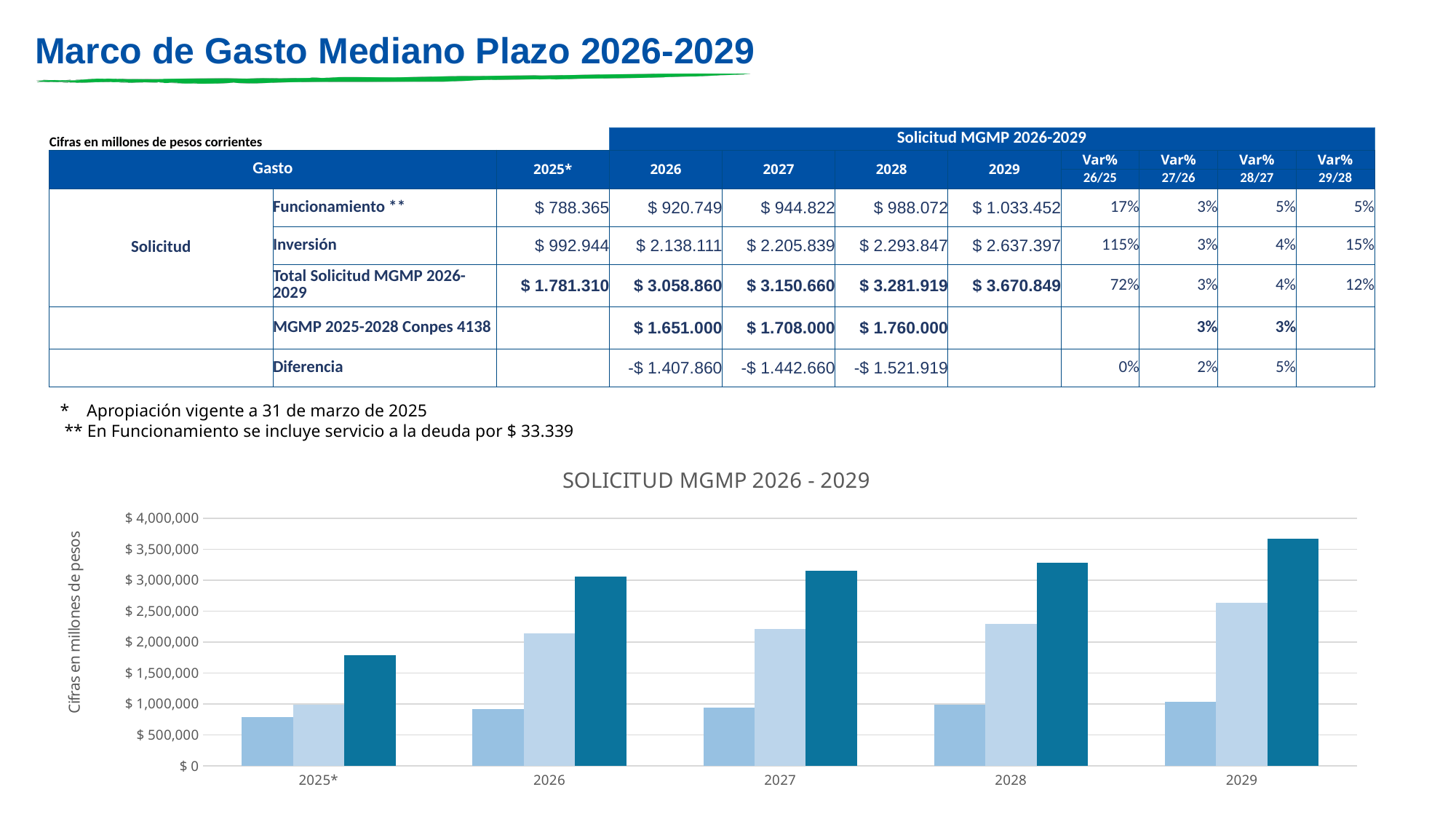
Is the lightest blue bar for 2025* greater or less than $ 1,000,000? less In which year is the tallest dark teal bar on the chart? 2029 Is the dark teal bar for 2029 greater or less than $ 3,500,000? greater What kind of chart is shown at the bottom of the slide? bar chart How many bars are plotted for each year on the chart? 3 How many year categories are shown on the x axis of the chart? 5 What is the title of the chart? SOLICITUD MGMP 2026 - 2029 What is the label on the vertical axis of the chart? Cifras en millones de pesos In which year is the shortest dark teal bar on the chart? 2025* Which is taller on the chart, the dark teal bar for 2028 or the dark teal bar for 2029? 2029 Do the dark teal bars rise or fall from 2025* to 2029 on the chart? rise Is the dark teal bar for 2025* greater or less than $ 2,000,000? less